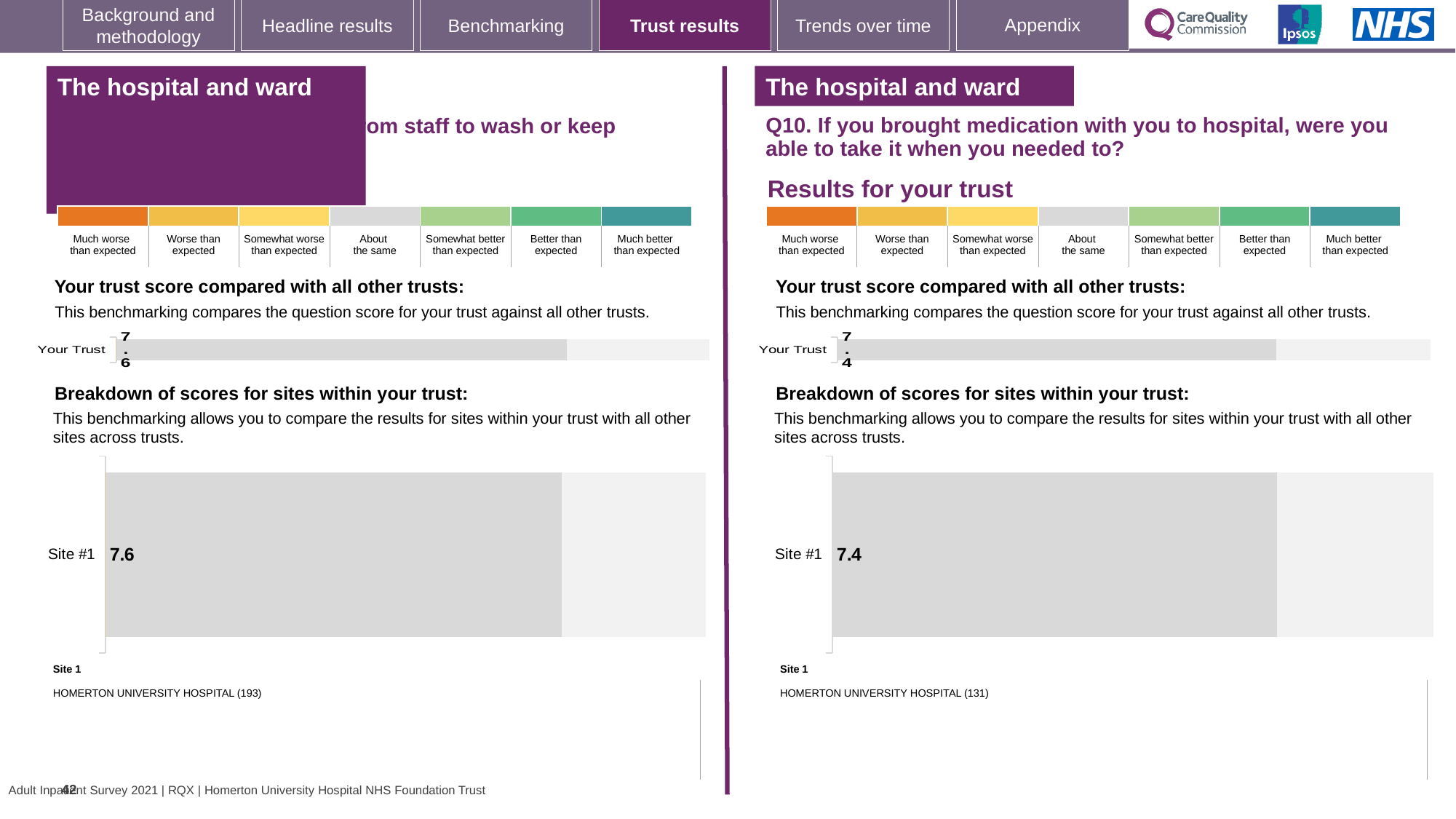
On the right-hand panel (Q10, medication), what is the score shown for Your Trust in the 'Your trust score compared with all other trusts' chart? 7.4 On the right-hand panel (Q10, medication), what is the score shown for Site #1 in the 'Breakdown of scores for sites within your trust' chart? 7.4 What is the difference between the Site #1 score on the left-hand panel (7.6) and the Site #1 score on the right-hand panel (7.4)? 0.2 On the left-hand panel, what number of respondents is shown in brackets next to HOMERTON UNIVERSITY HOSPITAL under Site 1? 193 How many sites are shown in the 'Breakdown of scores for sites within your trust' chart on the left-hand panel? 1 On the left-hand panel, what is the score shown for Site #1 in the 'Breakdown of scores for sites within your trust' chart? 7.6 On the right-hand panel, which site is listed as Site 1 below the breakdown chart? HOMERTON UNIVERSITY HOSPITAL (131) Which is larger: the Site #1 score on the left-hand panel or the Site #1 score on the right-hand panel (Q10)? Left-hand panel (7.6) What kind of chart is used to show the Site #1 score in the 'Breakdown of scores for sites within your trust' section on the right-hand panel? Bar chart On the left-hand panel, what is the score shown for Your Trust in the 'Your trust score compared with all other trusts' chart? 7.6 How many sites are shown in the 'Breakdown of scores for sites within your trust' chart on the right-hand panel (Q10)? 1